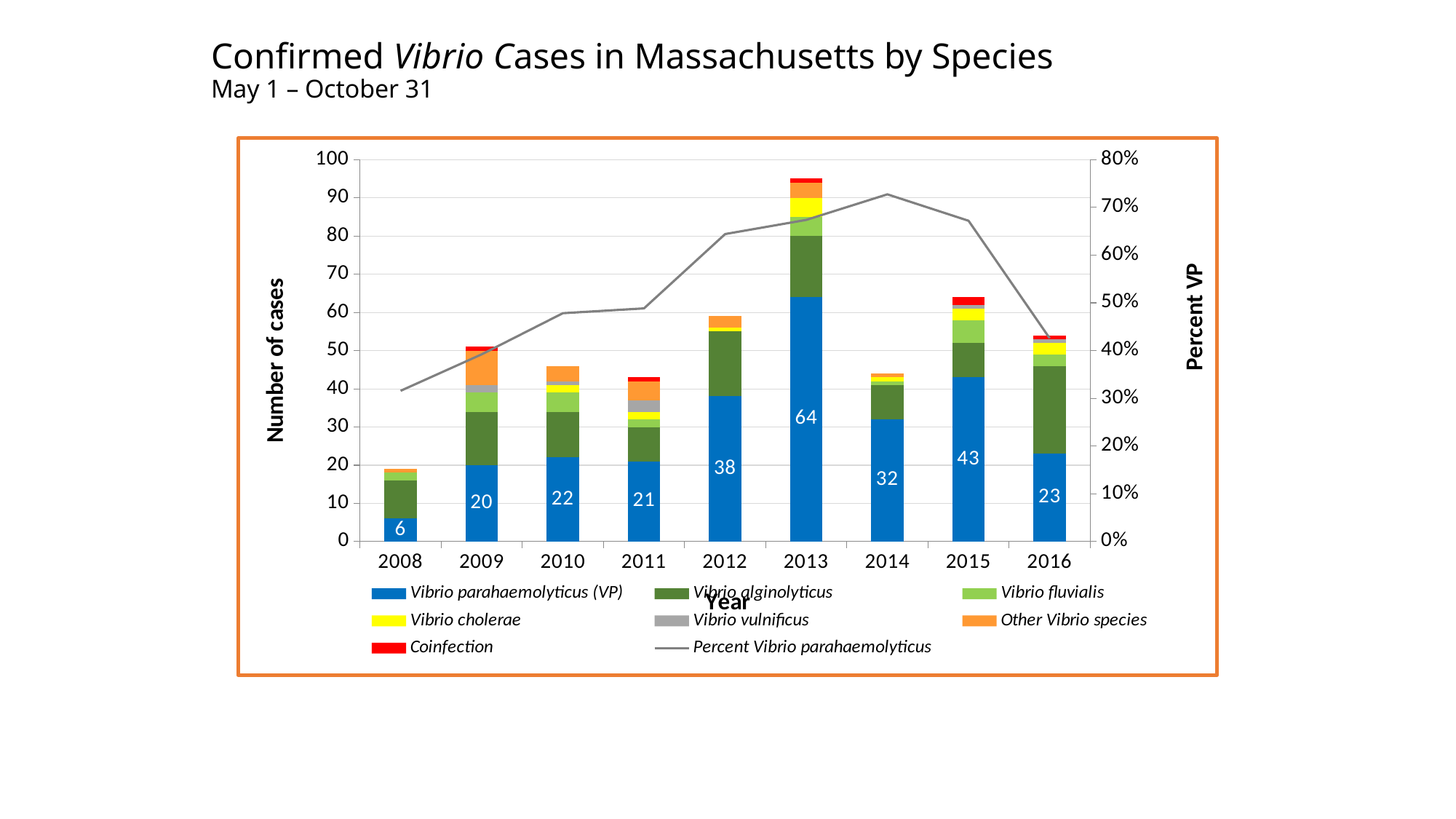
Is the Percent VP value for 2016 greater or less than 50%? less Which year has the highest number of Vibrio parahaemolyticus (VP) cases? 2013 How many years are shown on the x axis? 9 Which year has the lowest number of Vibrio parahaemolyticus (VP) cases? 2008 Is the total number of cases in 2014 greater or less than 40? greater How many entries does the legend list? 8 Which year had more Vibrio parahaemolyticus (VP) cases, 2014 or 2016? 2014 Does the Percent Vibrio parahaemolyticus line rise or fall from 2014 to 2016? fall What is the difference in Vibrio parahaemolyticus (VP) cases between 2013 and 2012? 26 How many confirmed Vibrio parahaemolyticus (VP) cases were there in 2013? 64 How many Vibrio parahaemolyticus (VP) cases are labeled for 2015? 43 What is the number of Vibrio parahaemolyticus (VP) cases shown for 2008? 6